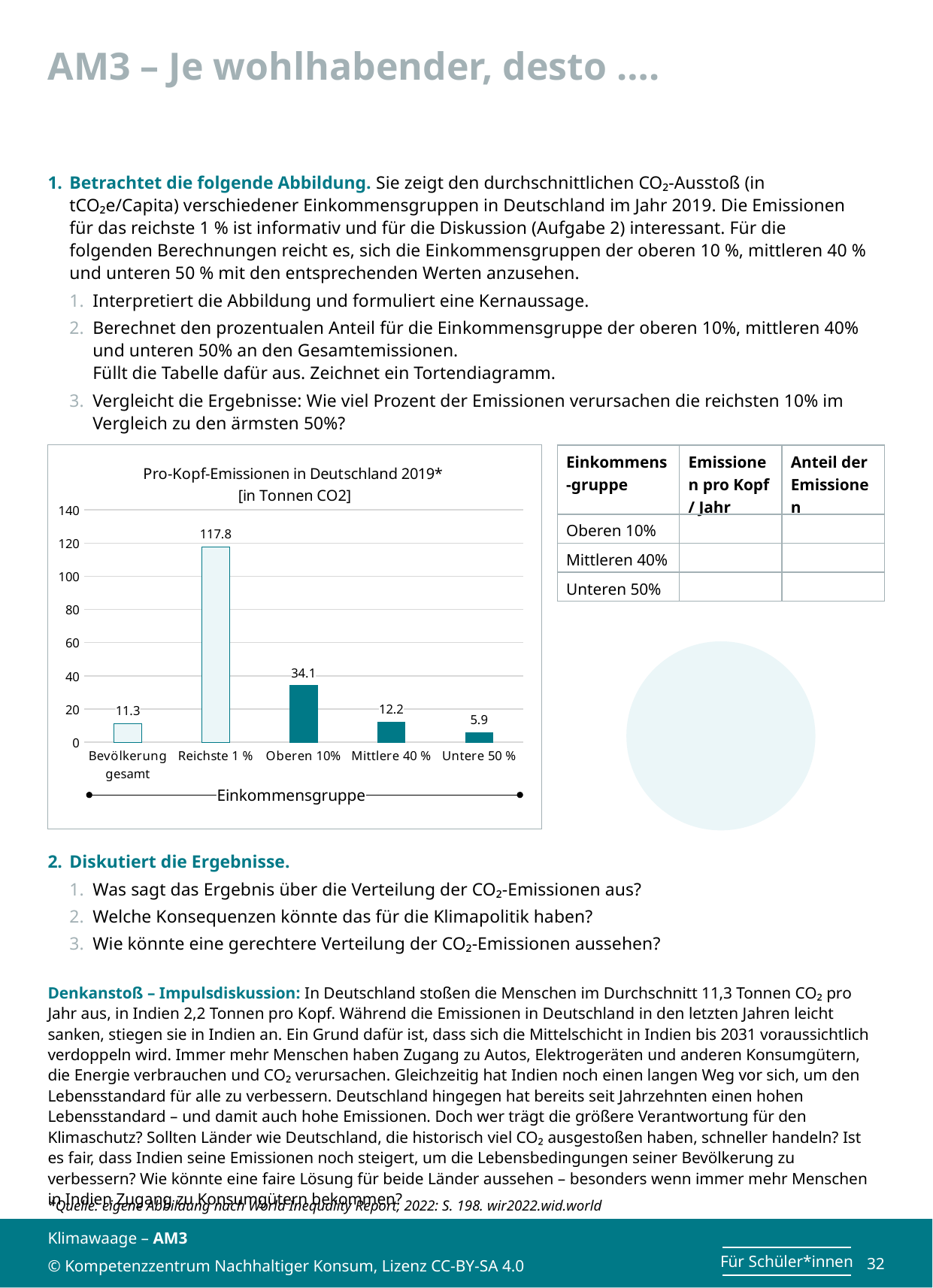
Which category has the lowest value in the chart? Untere 50 % Which is larger, the value for Mittlere 40 % or the value for Bevölkerung gesamt? Mittlere 40 % What is the value for Reichste 1 % in the chart? 117.8 How many categories are shown on the x axis of the chart? 5 Is the value for Reichste 1 % greater or less than 100? greater What is the value for Untere 50 % in the chart? 5.9 What is the value for Bevölkerung gesamt in the chart? 11.3 Which category has the highest value in the chart? Reichste 1 % What kind of chart is shown on the slide? bar chart What is the difference between the values for Oberen 10% and Untere 50 %? 28.2 What is the value for Oberen 10% in the chart? 34.1 What is the title of the chart? Pro-Kopf-Emissionen in Deutschland 2019* [in Tonnen CO2]